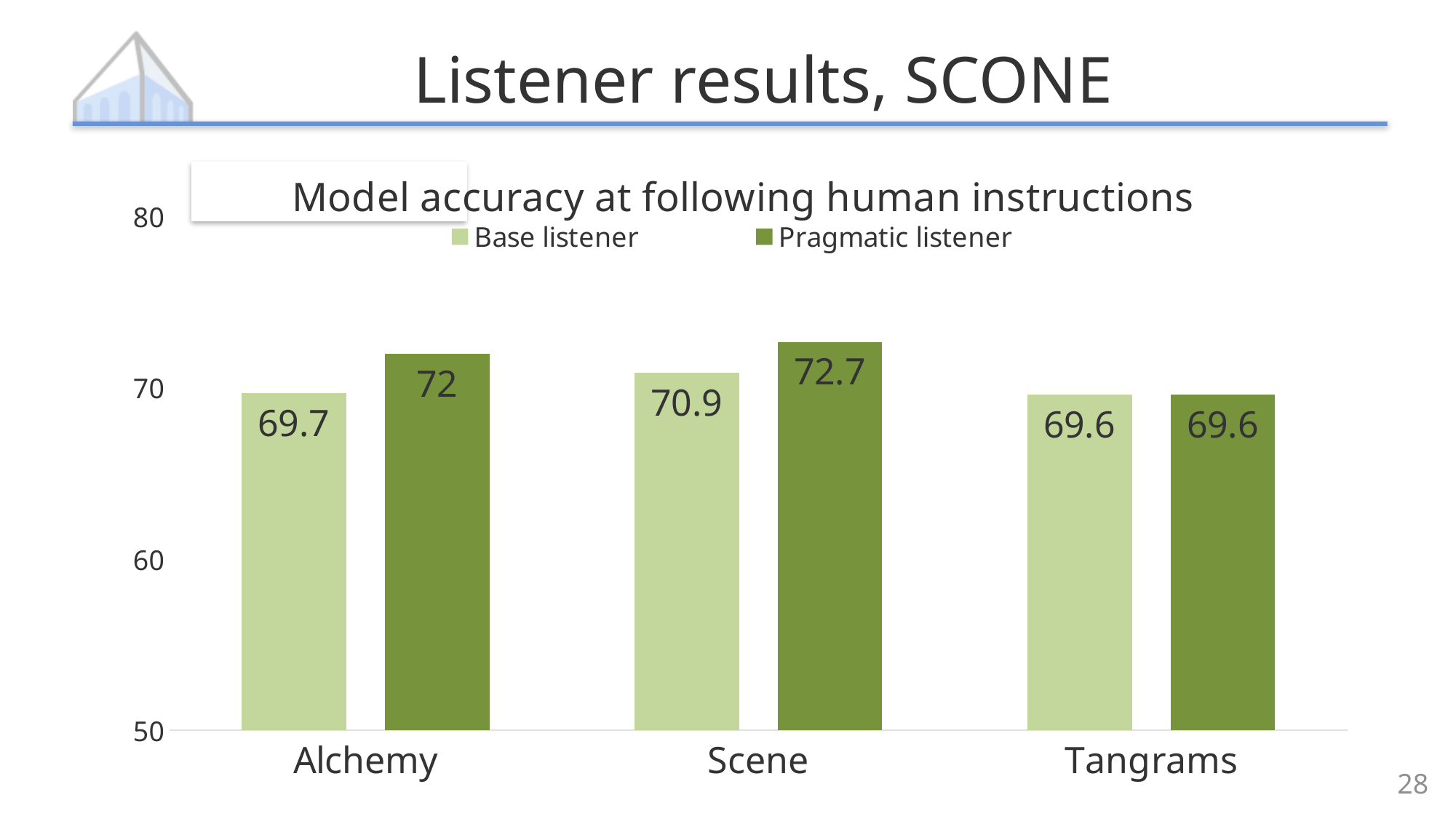
What is the difference between the Pragmatic listener and Base listener values for Alchemy? 2.3 Is the Pragmatic listener value for Alchemy greater or less than 70? greater What is the Base listener value for Alchemy? 69.7 How many categories are shown on the x axis? 3 What is the difference between the Pragmatic listener and Base listener values for Scene? 1.8 Which category has the highest Pragmatic listener value? Scene Which is larger for Scene, the Base listener value or the Pragmatic listener value? Pragmatic listener What is the Pragmatic listener value for Tangrams? 69.6 Which category has the lowest Base listener value? Tangrams How many series does the legend list? 2 What kind of chart is shown on the slide? bar chart What is the Pragmatic listener value for Scene? 72.7